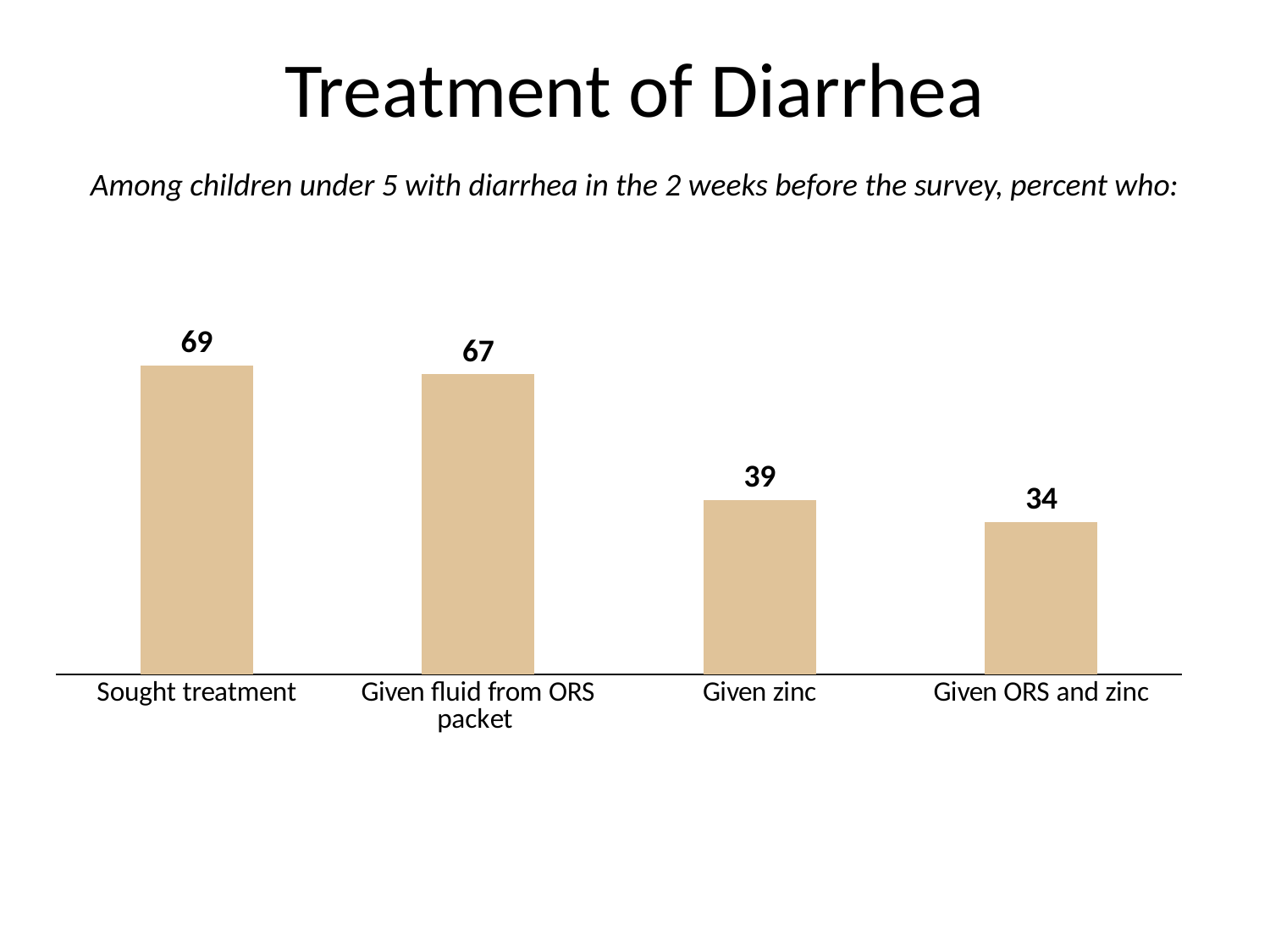
What is the value for 'Given ORS and zinc'? 34 How many categories are shown in the chart? 4 What is the value for 'Given fluid from ORS packet'? 67 What is the value for 'Given zinc'? 39 Which category has the lowest value? Given ORS and zinc What is the title of the slide? Treatment of Diarrhea What kind of chart is shown on the slide? Bar chart What percent of children under 5 with diarrhea sought treatment? 69 Which category has the highest value? Sought treatment What is the difference between the values for 'Given fluid from ORS packet' and 'Given zinc'? 28 What is the difference between the values for 'Given zinc' and 'Given ORS and zinc'? 5 Which is larger, the value for 'Sought treatment' or the value for 'Given fluid from ORS packet'? Sought treatment